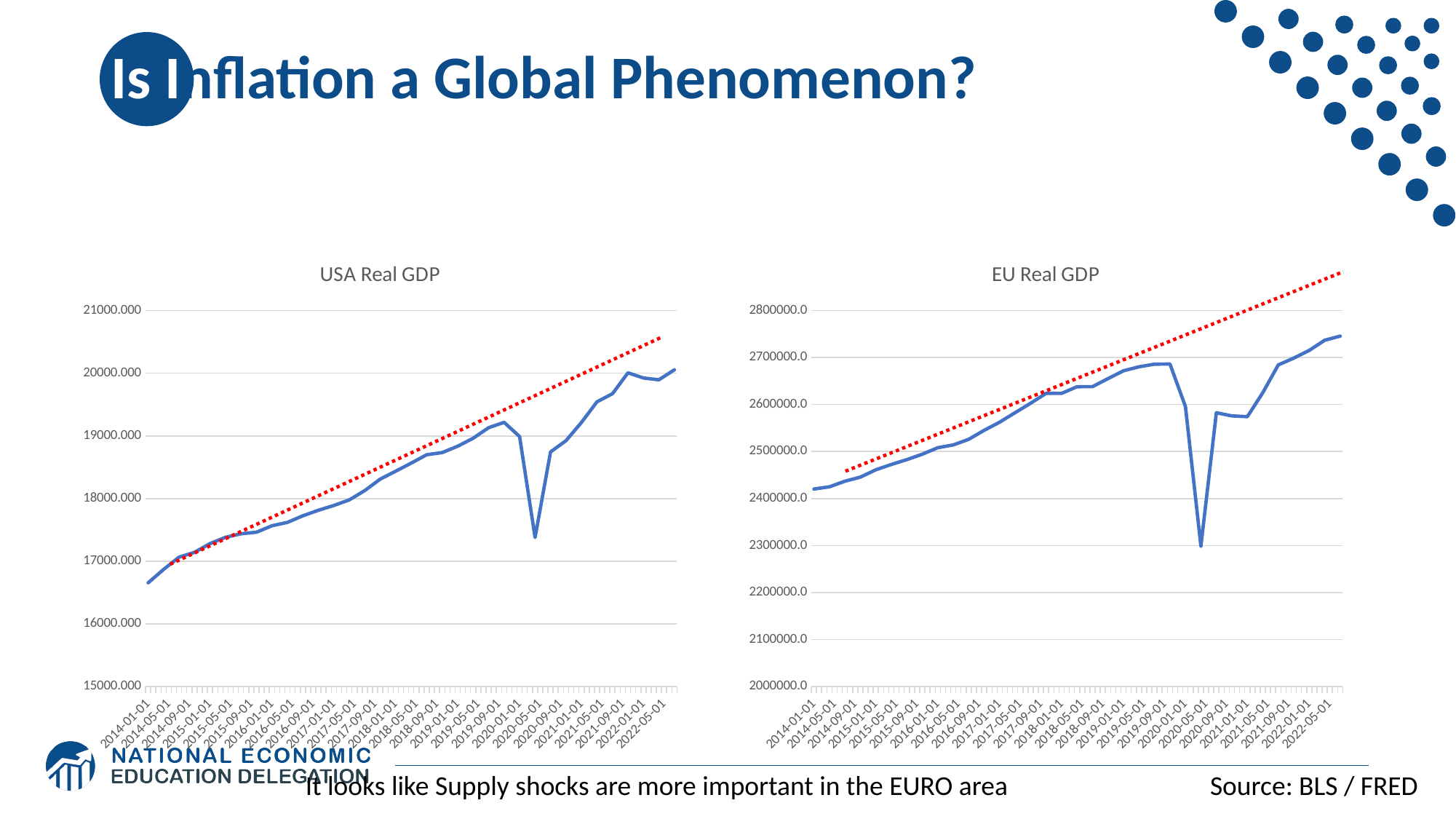
In the USA Real GDP chart, is the lowest point of the 2020 dip greater or less than 18000.000? less In the EU Real GDP chart, is the lowest point of the 2020 dip greater or less than 2400000.0? less In the USA Real GDP chart, is the value at 2022-05-01 greater or less than 19000.000? greater What is the title of the chart on the right side of the slide? EU Real GDP In the USA Real GDP chart, in which year does the sharp dip in the line occur? 2020 What kind of chart is the USA Real GDP chart? line chart In the EU Real GDP chart, which is larger, the value at 2022-05-01 or the value at 2014-01-01? 2022-05-01 What kind of chart is the EU Real GDP chart? line chart In the USA Real GDP chart, do values generally rise or fall from 2014-01-01 to 2022-05-01? rise